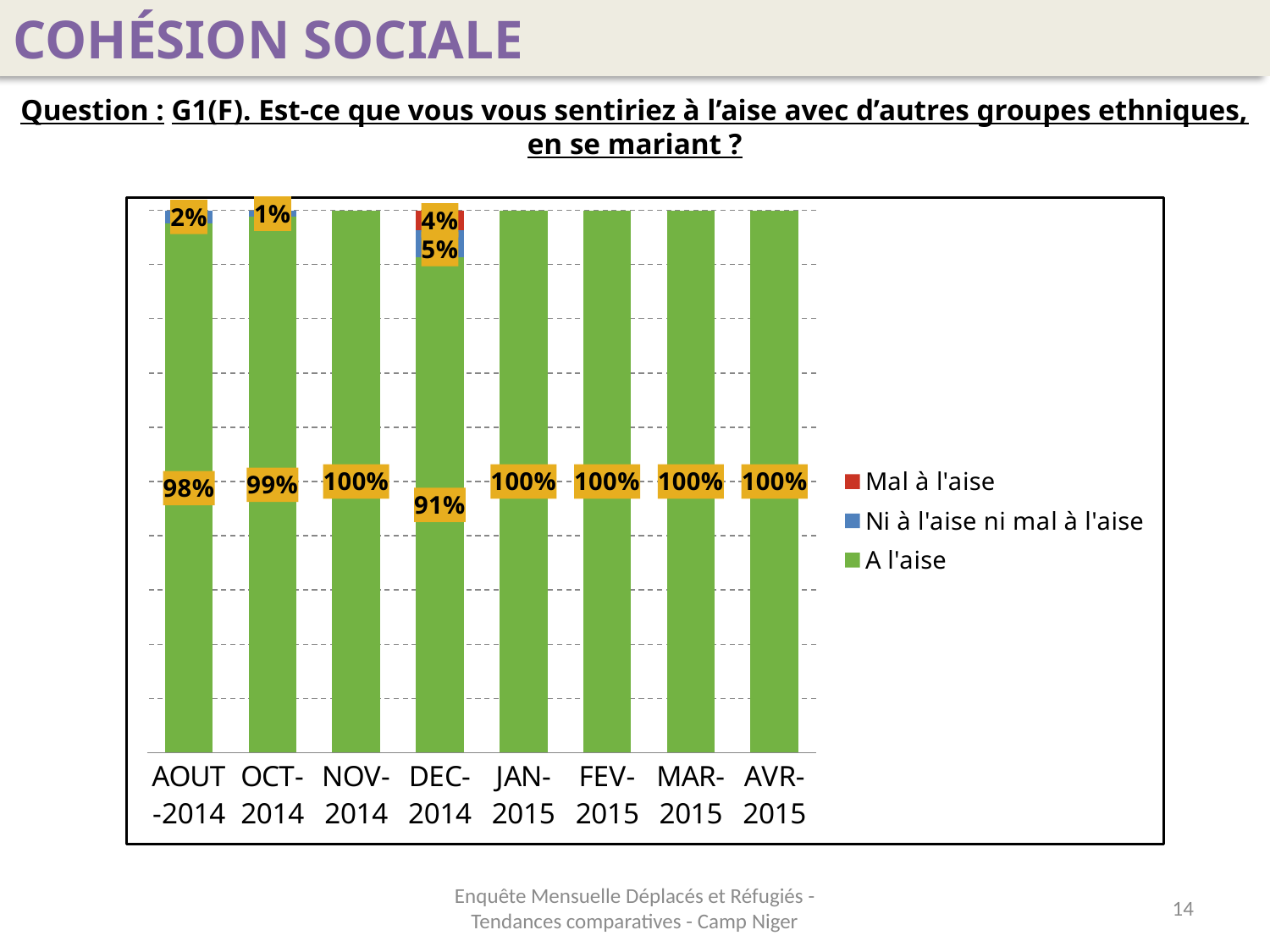
Which legend entry is shown in green? A l'aise How many series does the legend list? 3 What is the difference between the "A l'aise" value in OCT-2014 and in DEC-2014? 8% In which period is the "A l'aise" share lowest? DEC-2014 What is the value for "Mal à l'aise" in DEC-2014? 4% What is the value for "A l'aise" in DEC-2014? 91% Which is larger: the "A l'aise" value in AOUT-2014 or in DEC-2014? AOUT-2014 What is the value for "A l'aise" in AOUT-2014? 98% How many time periods (categories) are shown on the x axis? 8 What is the value for "Ni à l'aise ni mal à l'aise" in DEC-2014? 5% What kind of chart is shown on the slide? Stacked bar chart What is the value for "Ni à l'aise ni mal à l'aise" in OCT-2014? 1%